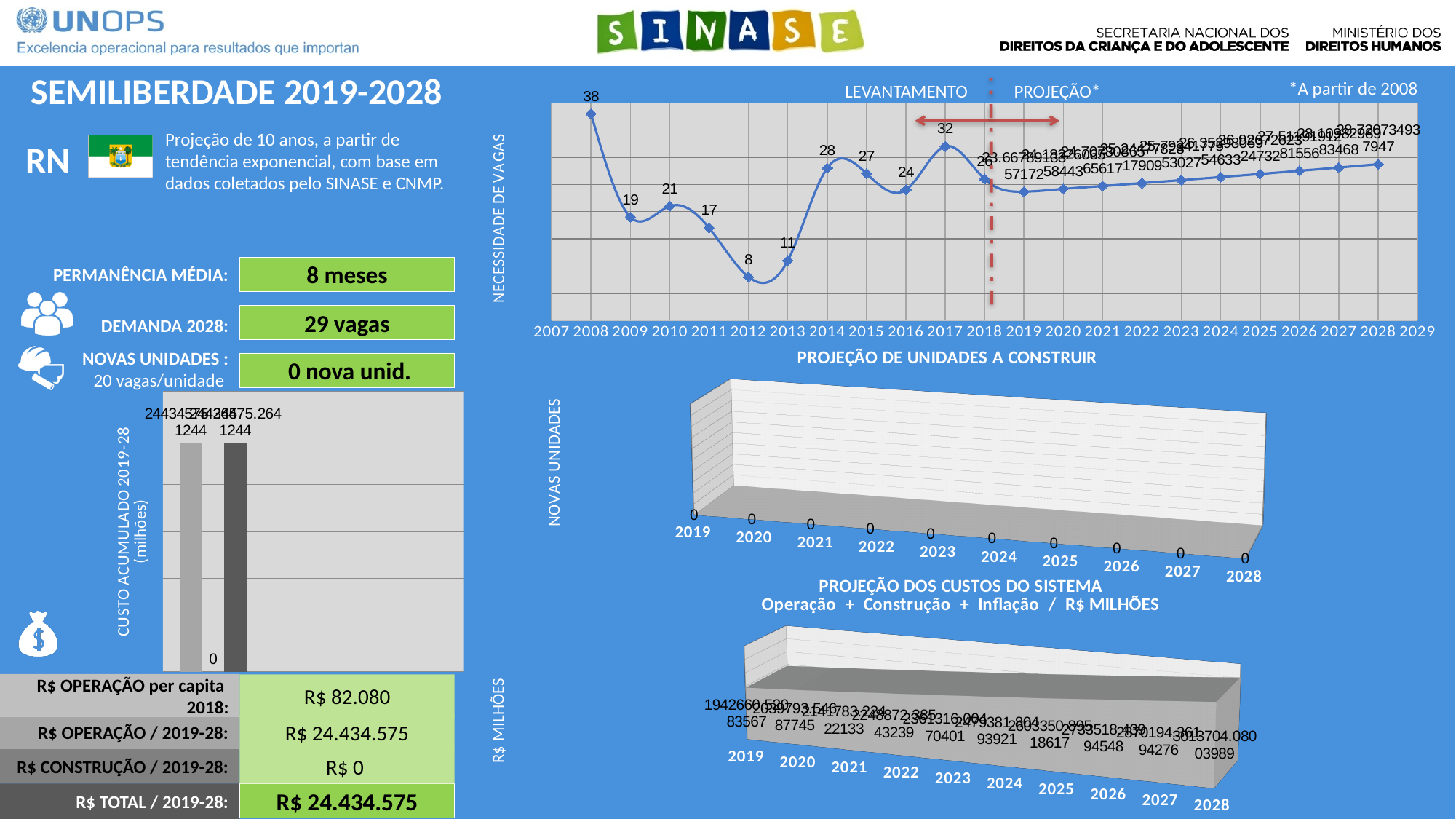
What kind of chart is the top-right chart labelled NECESSIDADE DE VAGAS? line chart In the NECESSIDADE DE VAGAS line chart, which year has the lowest value? 2012 How many years are shown on the x axis of the PROJEÇÃO DE UNIDADES A CONSTRUIR chart? 10 In the NECESSIDADE DE VAGAS line chart, which year has the highest value? 2008 In the NECESSIDADE DE VAGAS line chart, what is the value for 2008? 38 In the NECESSIDADE DE VAGAS line chart, do the values rise or fall from 2014 to 2016? fall In the NECESSIDADE DE VAGAS line chart, which is larger, the value for 2014 or the value for 2015? 2014 What kind of chart is the PROJEÇÃO DOS CUSTOS DO SISTEMA chart? area chart In the PROJEÇÃO DE UNIDADES A CONSTRUIR chart, what is the value for 2025? 0 In the NECESSIDADE DE VAGAS line chart, what is the value for 2012? 8 In the NECESSIDADE DE VAGAS line chart, what is the value for 2017? 32 In the NECESSIDADE DE VAGAS line chart, what is the difference between the values for 2008 and 2009? 19